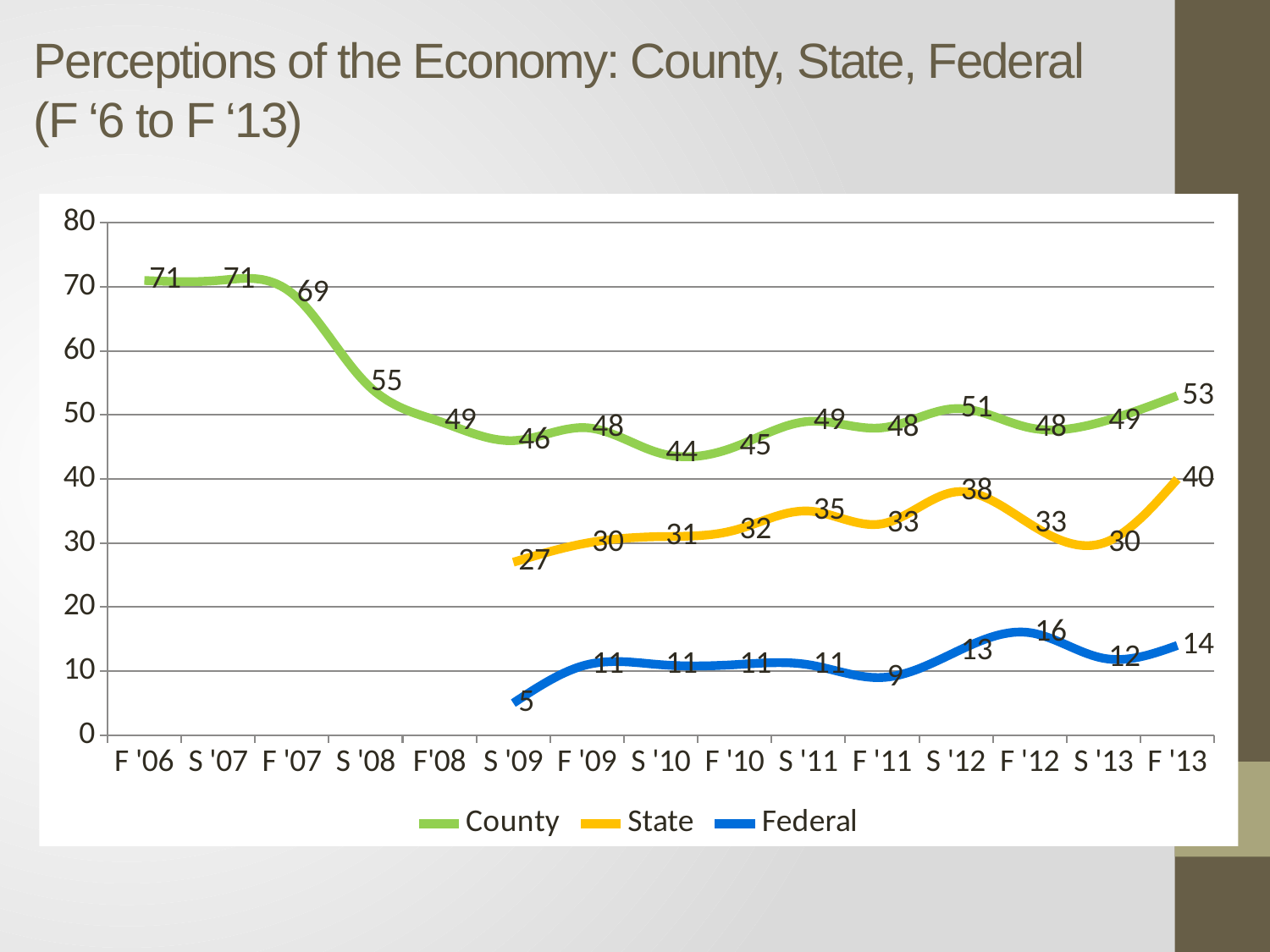
What kind of chart is shown on the slide? Line chart What is the County value at F '06? 71 How much higher is the County value at F '06 than at F '13? 18 How many periods are shown on the x axis? 15 At which period is the County series lowest? S '10 What is the State value at F '13? 40 What is the Federal value at S '09? 5 At which period is the Federal series lowest? S '09 Which is larger for the State series: the value at S '12 or at F '12? S '12 Does the County series rise or fall from F '06 to F'08? Fall At which period is the State series highest? F '13 How many series does the legend list? 3